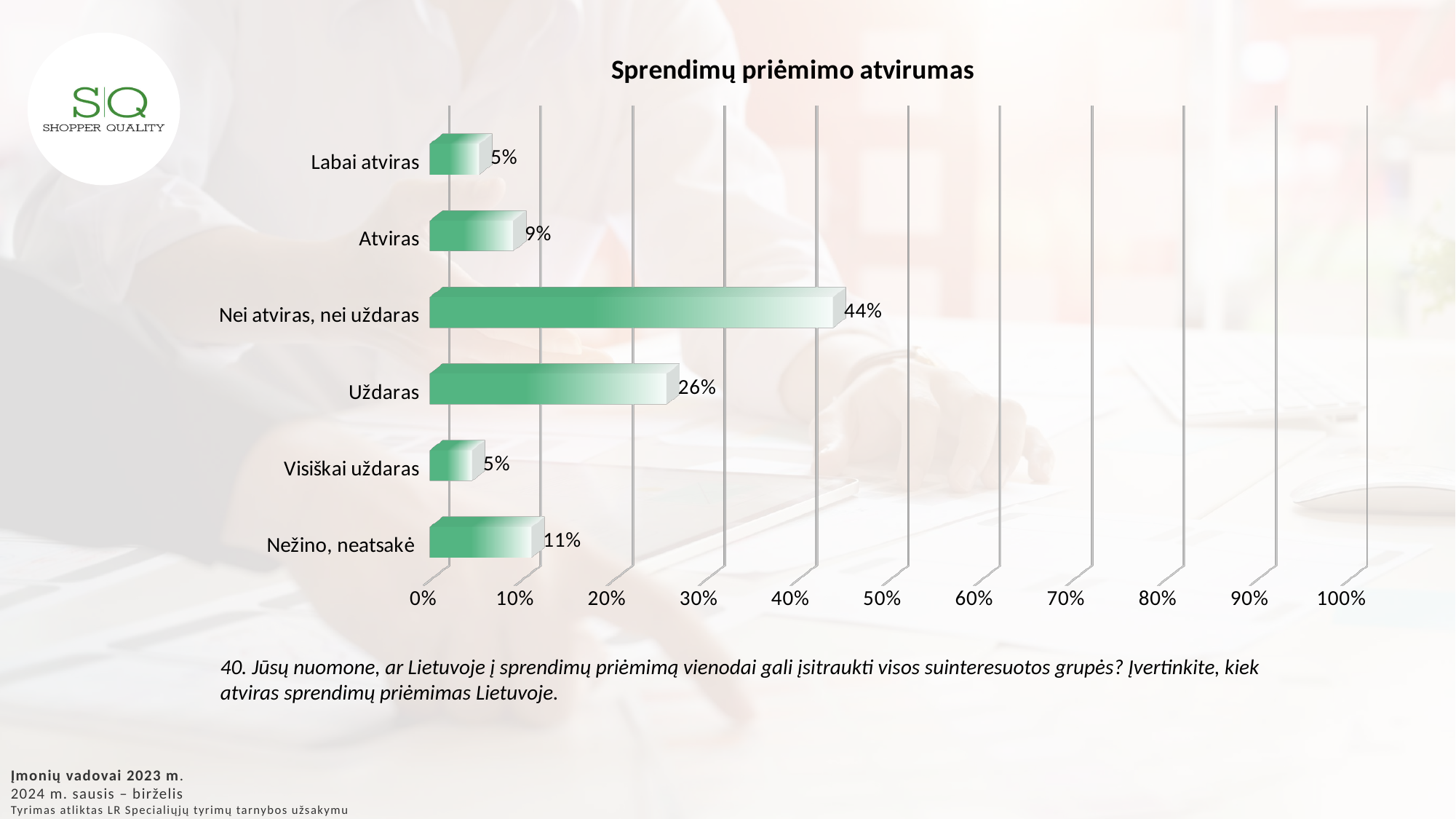
Which is larger, the value for 'Atviras' or the value for 'Nežino, neatsakė'? Nežino, neatsakė What is the value for 'Nei atviras, nei uždaras'? 44% What is the combined value of 'Labai atviras' and 'Atviras'? 14% What is the value for 'Uždaras'? 26% Is the value for 'Uždaras' greater or less than 20%? greater How many categories are shown in the chart? 6 Which category has the highest value? Nei atviras, nei uždaras What is the title of the chart? Sprendimų priėmimo atvirumas What is the value for 'Nežino, neatsakė'? 11% What is the difference between the values for 'Nei atviras, nei uždaras' and 'Uždaras'? 18% What is the value for 'Atviras'? 9% What kind of chart is shown on the slide? bar chart